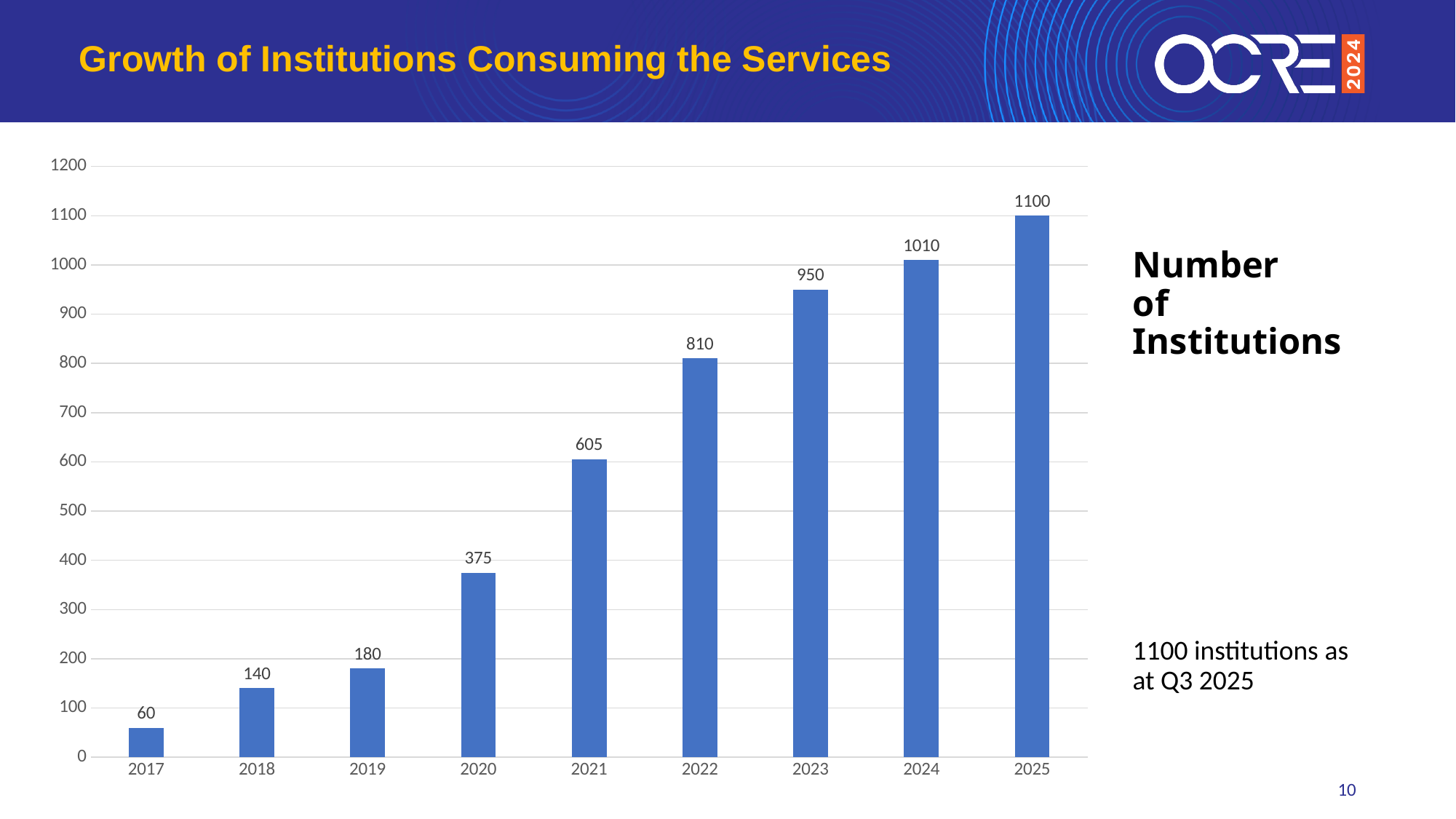
What is the number of institutions in 2020? 375 What is the number of institutions in 2023? 950 Which year has the lowest number of institutions? 2017 What is the difference between the number of institutions in 2022 and in 2021? 205 What kind of chart is shown on the slide? Bar chart Which year has the highest number of institutions? 2025 How many years are shown on the x axis? 9 Do the values rise or fall from 2017 to 2025? Rise Which year has more institutions, 2019 or 2018? 2019 What is the number of institutions in 2017? 60 Is the value for 2021 greater or less than 500? greater What is the difference between the number of institutions in 2025 and in 2024? 90